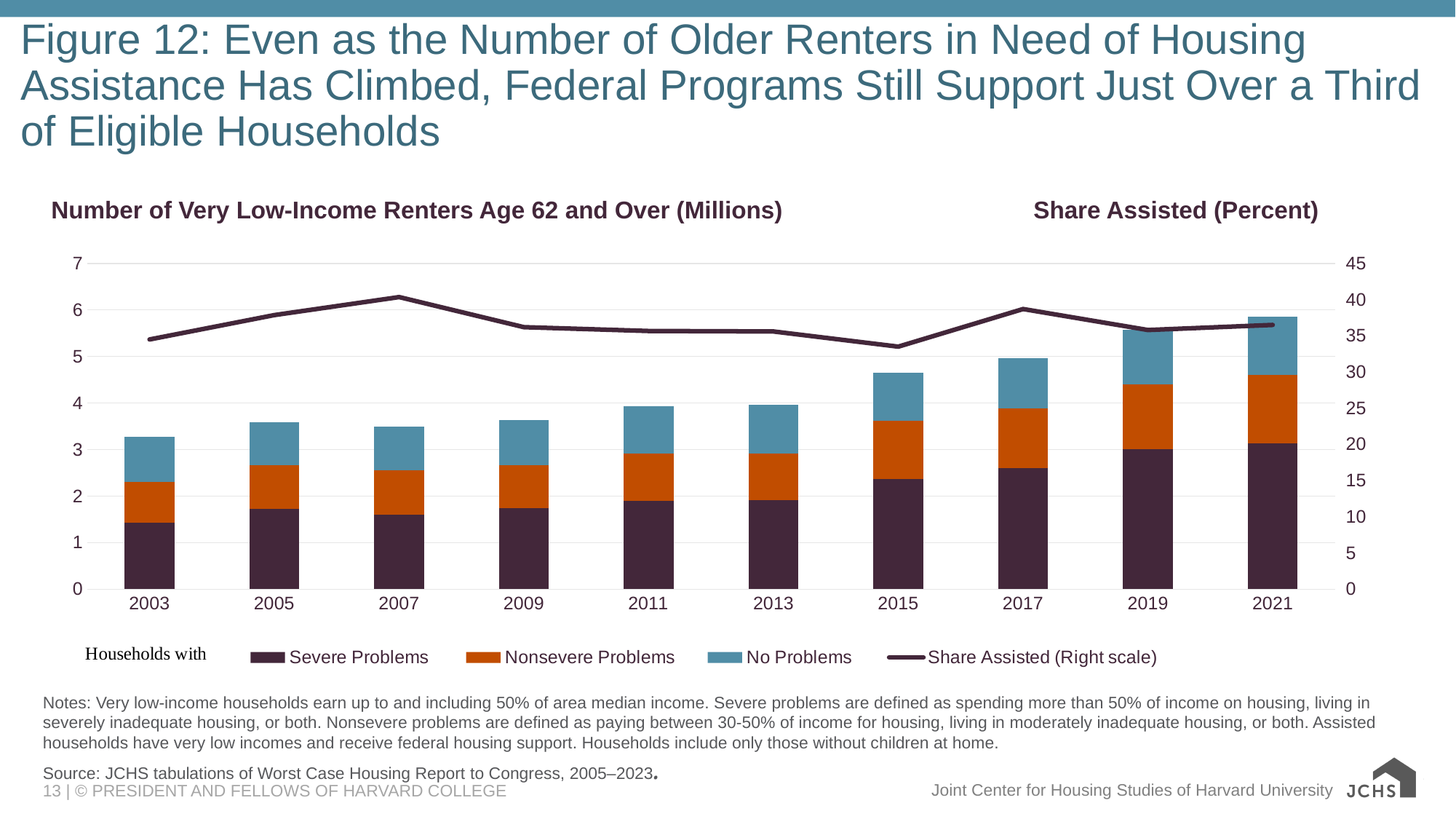
In which year does the Share Assisted line reach its lowest point? 2015 What kind of chart is shown on the slide? A combined stacked bar and line chart How many series does the legend list? 4 Is the total number of very low-income renters age 62 and over in 2021 greater or less than 5 million? greater Is the total number of very low-income renters age 62 and over in 2003 greater or less than 4 million? less How many years are shown along the x axis? 10 Which year has the larger Share Assisted value, 2007 or 2015? 2007 In which year does the Share Assisted line reach its highest point? 2007 Do the stacked bar totals generally rise or fall from 2003 to 2021? rise Which year has the shortest stacked bar for the number of very low-income renters age 62 and over? 2003 Is the number of households with Severe Problems in 2019 greater or less than 2 million? greater Which year has the tallest stacked bar for the number of very low-income renters age 62 and over? 2021